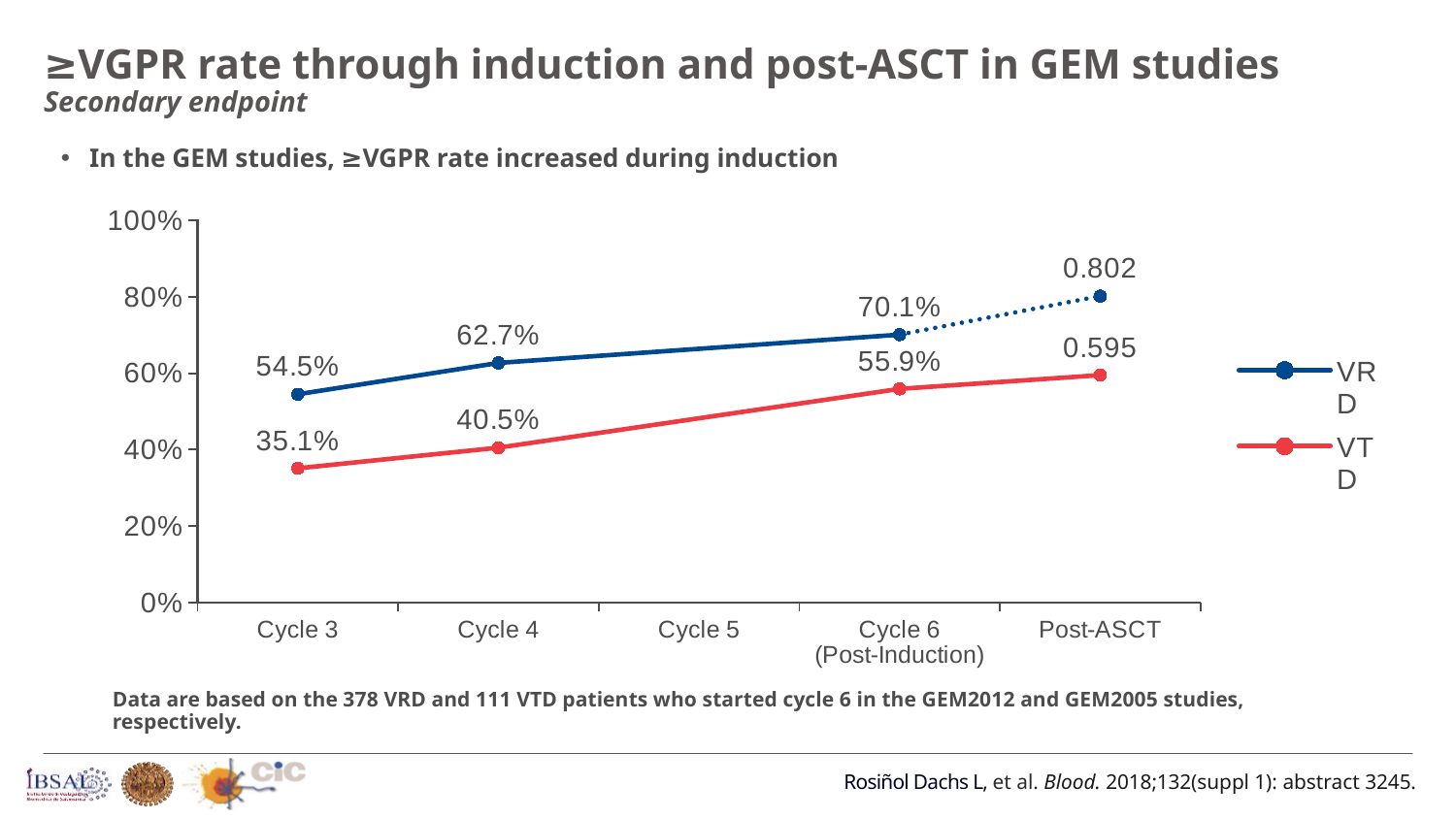
What value is labelled for VRD at Post-ASCT? 0.802 What kind of chart is shown on the slide? Line chart Which series has the higher ≥VGPR rate at Cycle 4, VRD or VTD? VRD Does the VRD ≥VGPR rate rise or fall from Cycle 3 to Post-ASCT? Rise What value is labelled for VTD at Cycle 6 (Post-Induction)? 55.9% What is the ≥VGPR rate for VRD at Cycle 3? 54.5% At which x-axis point is the VTD ≥VGPR rate lowest? Cycle 3 What is the ≥VGPR rate for VTD at Cycle 4? 40.5% What is the difference between the VRD and VTD ≥VGPR rates at Cycle 3? 19.4 percentage points Is the VRD value at Cycle 6 (Post-Induction) greater or less than 60%? greater How many series does the legend list? 2 What is the difference between the VRD and VTD ≥VGPR rates at Cycle 6 (Post-Induction)? 14.2 percentage points